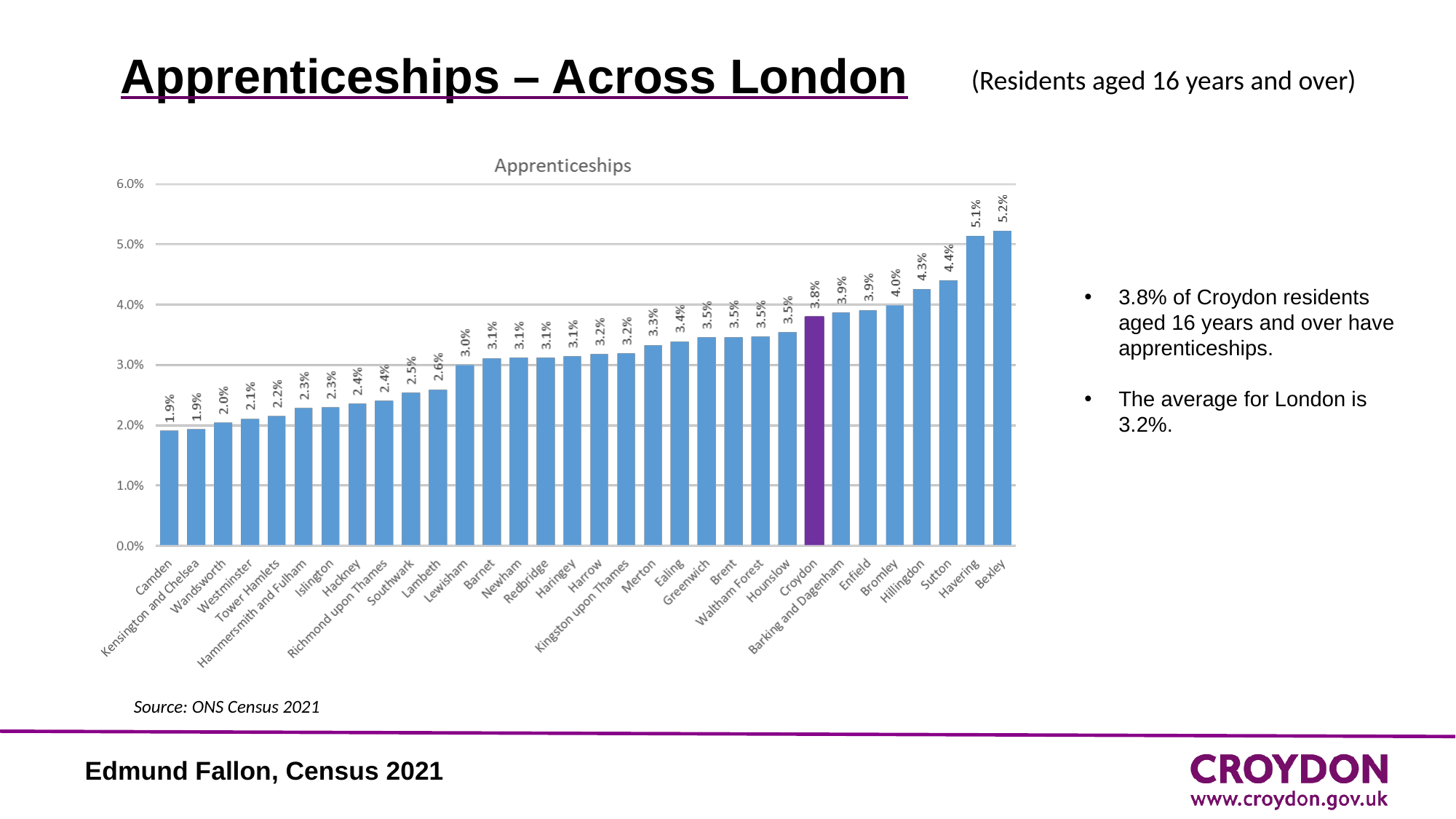
What is the apprenticeships value for Croydon? 3.8% What is the apprenticeships value for Havering? 5.1% How many boroughs are shown on the chart? 32 Do the values rise or fall from left to right along the x axis? Rise What is the apprenticeships value for Lewisham? 3.0% What is the difference between the values for Croydon and Camden? 1.9% Which borough's bar is coloured purple instead of blue? Croydon What is the difference between the values for Bexley and Croydon? 1.4% Which has a higher value, Sutton or Hillingdon? Sutton Which has a higher value, Lambeth or Lewisham? Lewisham What kind of chart is shown on the slide? Bar chart Which borough has the highest apprenticeships value? Bexley